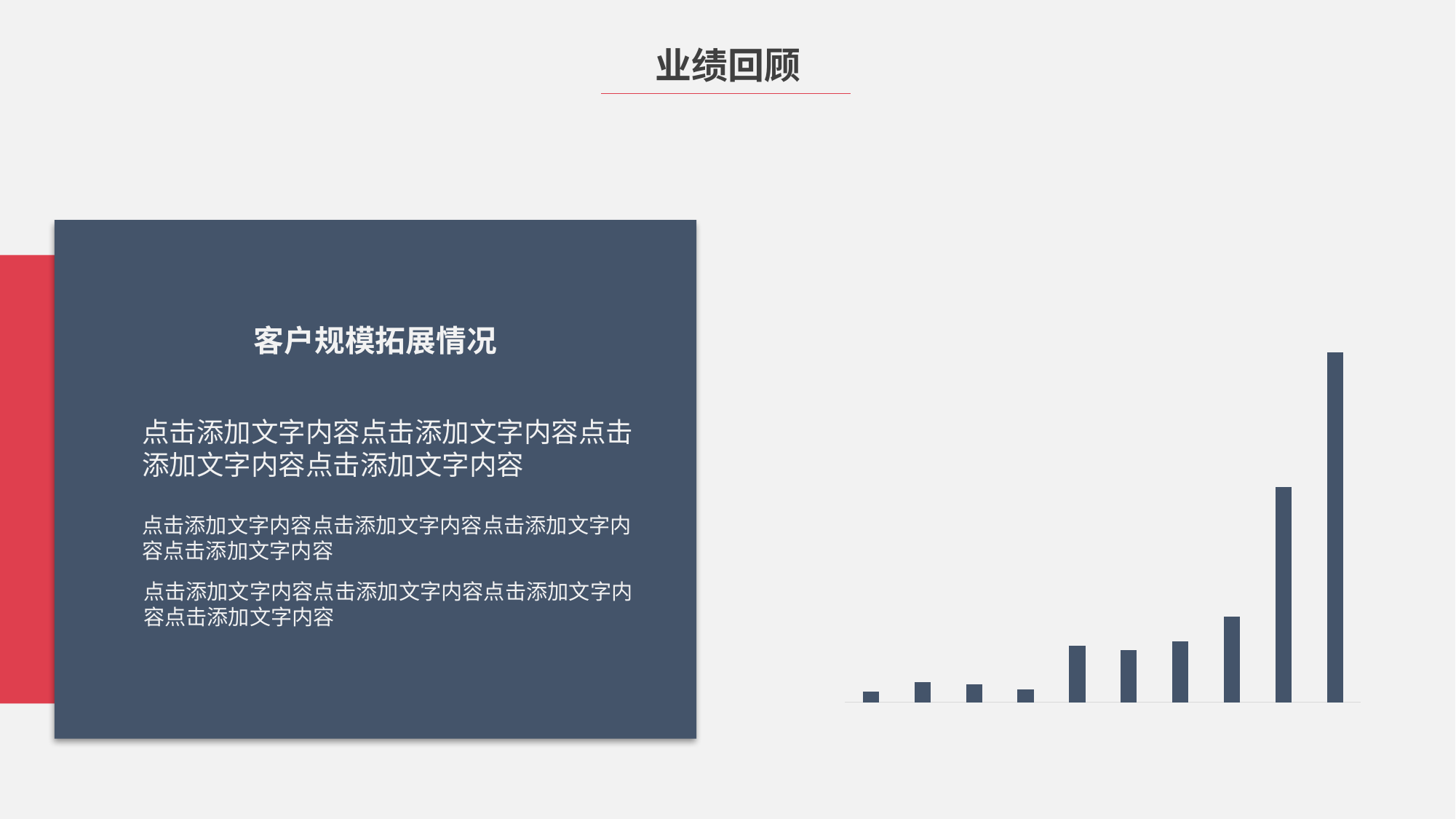
Does the chart display a legend? No What colour are the bars in the chart? dark blue-grey How many bars does the chart on the right side of the slide contain? 10 Which bar in the chart is the tallest? the rightmost (last) bar Which is taller, the ninth bar or the tenth bar from the left? the tenth bar Which bar in the chart is the shortest? the leftmost (first) bar Do the bar values generally rise or fall from left to right across the chart? rise Which is taller, the eighth bar or the seventh bar from the left? the eighth bar Which is taller, the second bar or the fourth bar from the left? the second bar What kind of chart is shown on the right side of the slide? bar chart